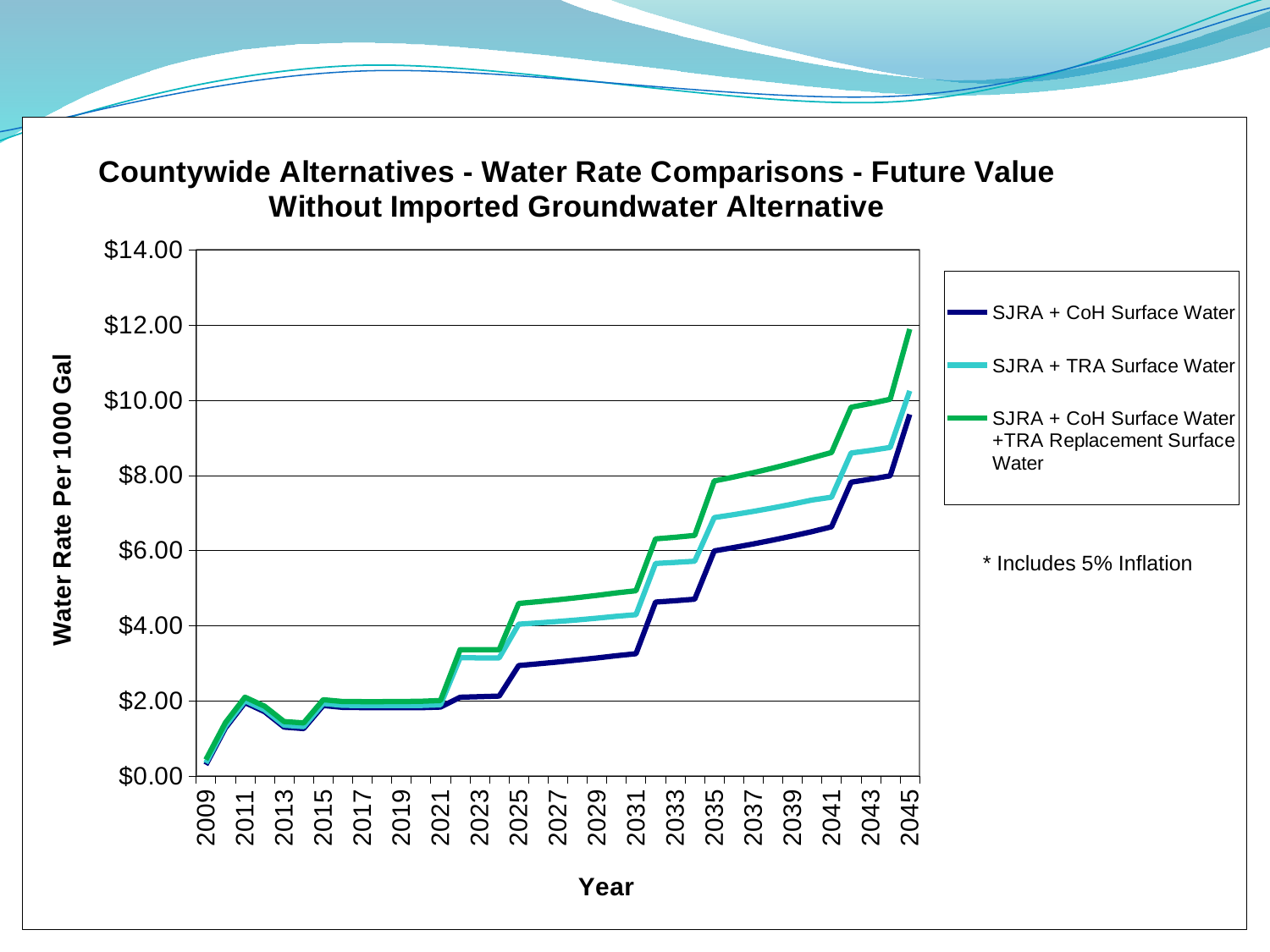
In 2035, which is larger: SJRA + TRA Surface Water or SJRA + CoH Surface Water? SJRA + TRA Surface Water Do the water rates generally rise or fall from 2009 to 2045? rise Is the value for SJRA + CoH Surface Water in 2045 greater or less than $10.00? less Which series has the lowest value in 2045? SJRA + CoH Surface Water Is the value for SJRA + CoH Surface Water +TRA Replacement Surface Water in 2045 greater or less than $10.00? greater Is the value for SJRA + TRA Surface Water in 2035 greater or less than $6.00? greater Which series has the highest value in 2045? SJRA + CoH Surface Water +TRA Replacement Surface Water What kind of chart is shown on the slide? line chart What is the title of the chart? Countywide Alternatives - Water Rate Comparisons - Future Value Without Imported Groundwater Alternative What is the label on the y axis? Water Rate Per 1000 Gal How many series does the legend list? 3